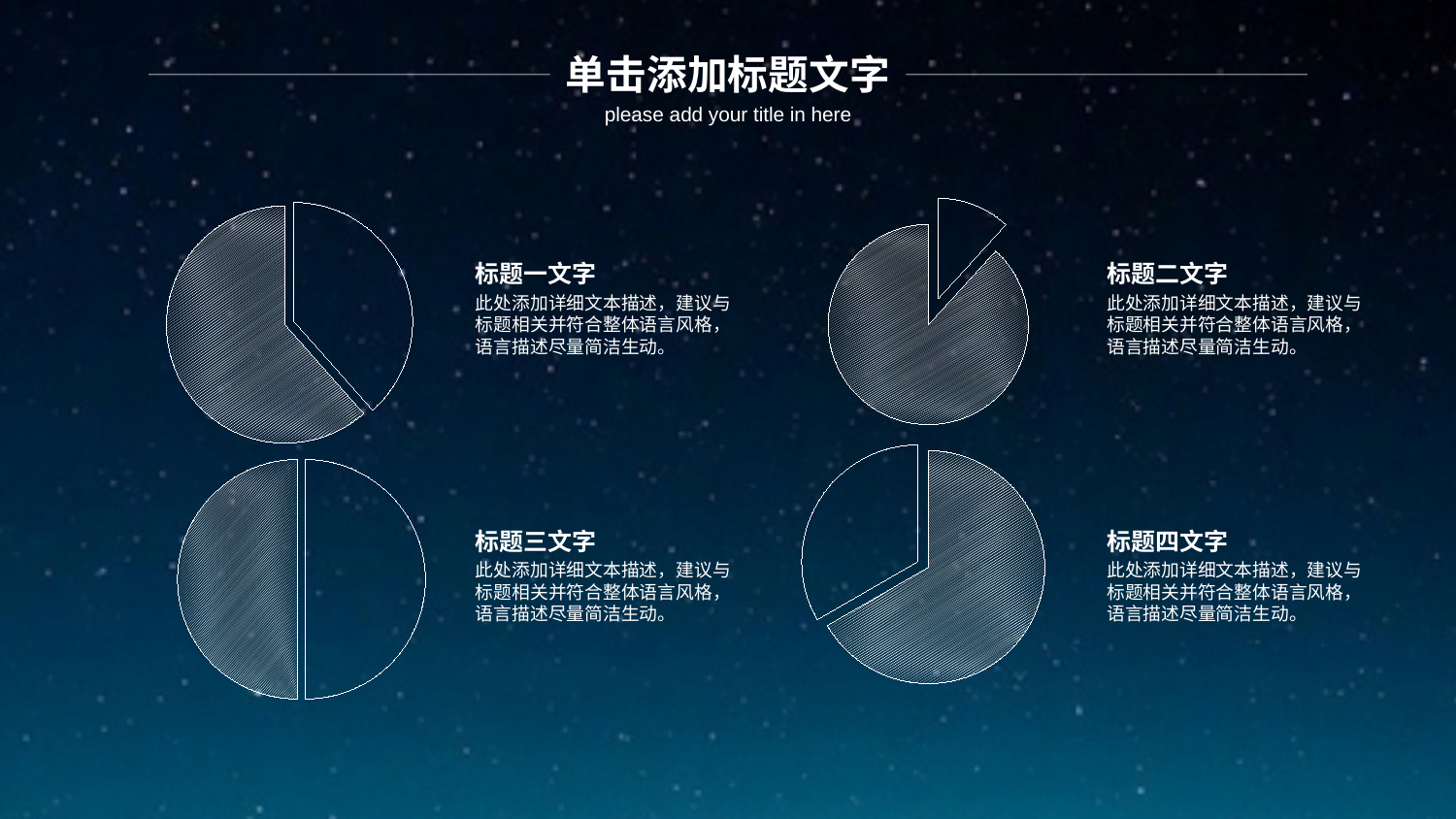
How many slices does the pie chart next to 标题二文字 have? 2 What kind of chart is shown next to 标题一文字? pie chart In the pie chart next to 标题二文字, which slice is larger, the hatched slice or the unfilled slice? the hatched slice Do any of the pie charts on the slide show data labels with values? No How many pie charts are on the slide? 4 Which pie chart on the slide has the smallest unfilled slice? the one next to 标题二文字 How many slices does the pie chart next to 标题四文字 have? 2 In the pie chart next to 标题四文字, which slice is larger, the hatched slice or the unfilled slice? the hatched slice What is the main title of the slide? 单击添加标题文字 In the pie chart next to 标题一文字, which slice is larger, the hatched slice or the unfilled slice? the hatched slice